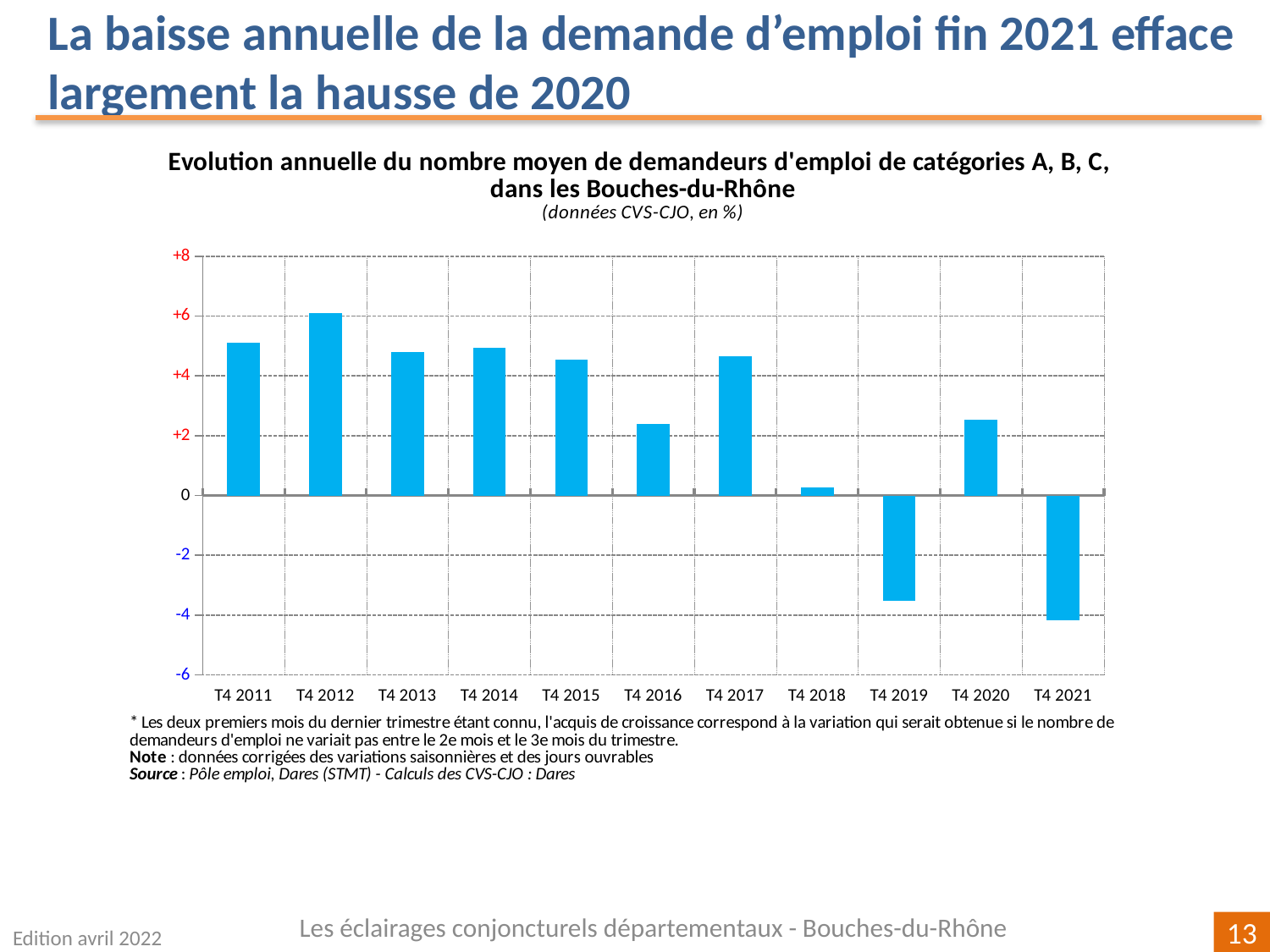
Is the value for T4 2012 greater or less than +4? greater Is the value for T4 2019 greater or less than -2? less How many quarters show a negative value? 2 In what unit are the chart's data expressed, according to the subtitle? % Which quarter has the highest value? T4 2012 Is the value for T4 2018 greater or less than +2? less What kind of chart is shown on the slide? bar chart Which quarter has the lowest value? T4 2021 Which is larger, the value for T4 2017 or the value for T4 2020? T4 2017 Which is larger, the value for T4 2011 or the value for T4 2016? T4 2011 How many quarters (categories) are plotted on the x axis? 11